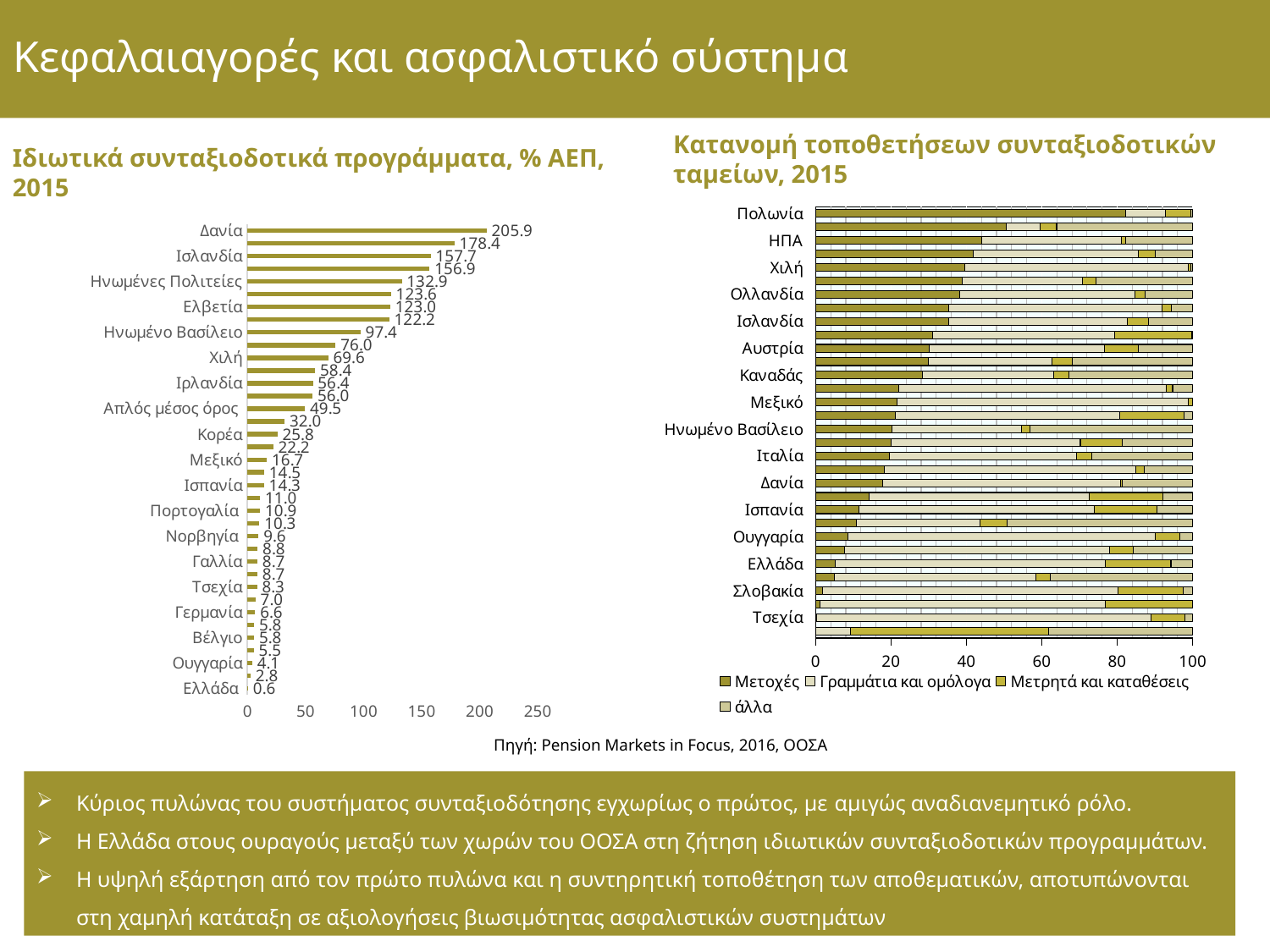
In the chart 'Ιδιωτικά συνταξιοδοτικά προγράμματα, % ΑΕΠ, 2015', which is larger, the value for Χιλή or the value for Ιρλανδία? Χιλή What kind of chart is 'Ιδιωτικά συνταξιοδοτικά προγράμματα, % ΑΕΠ, 2015'? Bar chart In the chart 'Κατανομή τοποθετήσεων συνταξιοδοτικών ταμείων, 2015', is the Μετοχές value for Ελλάδα greater or less than 20? less In the chart 'Ιδιωτικά συνταξιοδοτικά προγράμματα, % ΑΕΠ, 2015', what is the value for Δανία? 205.9 In the chart 'Ιδιωτικά συνταξιοδοτικά προγράμματα, % ΑΕΠ, 2015', what is the difference between the values for Δανία and Ισλανδία? 48.2 In the chart 'Ιδιωτικά συνταξιοδοτικά προγράμματα, % ΑΕΠ, 2015', which country has the highest value? Δανία What kind of chart is 'Κατανομή τοποθετήσεων συνταξιοδοτικών ταμείων, 2015'? Stacked bar chart In the chart 'Ιδιωτικά συνταξιοδοτικά προγράμματα, % ΑΕΠ, 2015', what is the value for Απλός μέσος όρος? 49.5 How many series does the legend of the chart 'Κατανομή τοποθετήσεων συνταξιοδοτικών ταμείων, 2015' list? 4 In the chart 'Ιδιωτικά συνταξιοδοτικά προγράμματα, % ΑΕΠ, 2015', what is the value for Ελλάδα? 0.6 In the chart 'Ιδιωτικά συνταξιοδοτικά προγράμματα, % ΑΕΠ, 2015', what is the value for Ηνωμένο Βασίλειο? 97.4 In the chart 'Ιδιωτικά συνταξιοδοτικά προγράμματα, % ΑΕΠ, 2015', which country has the lowest value? Ελλάδα